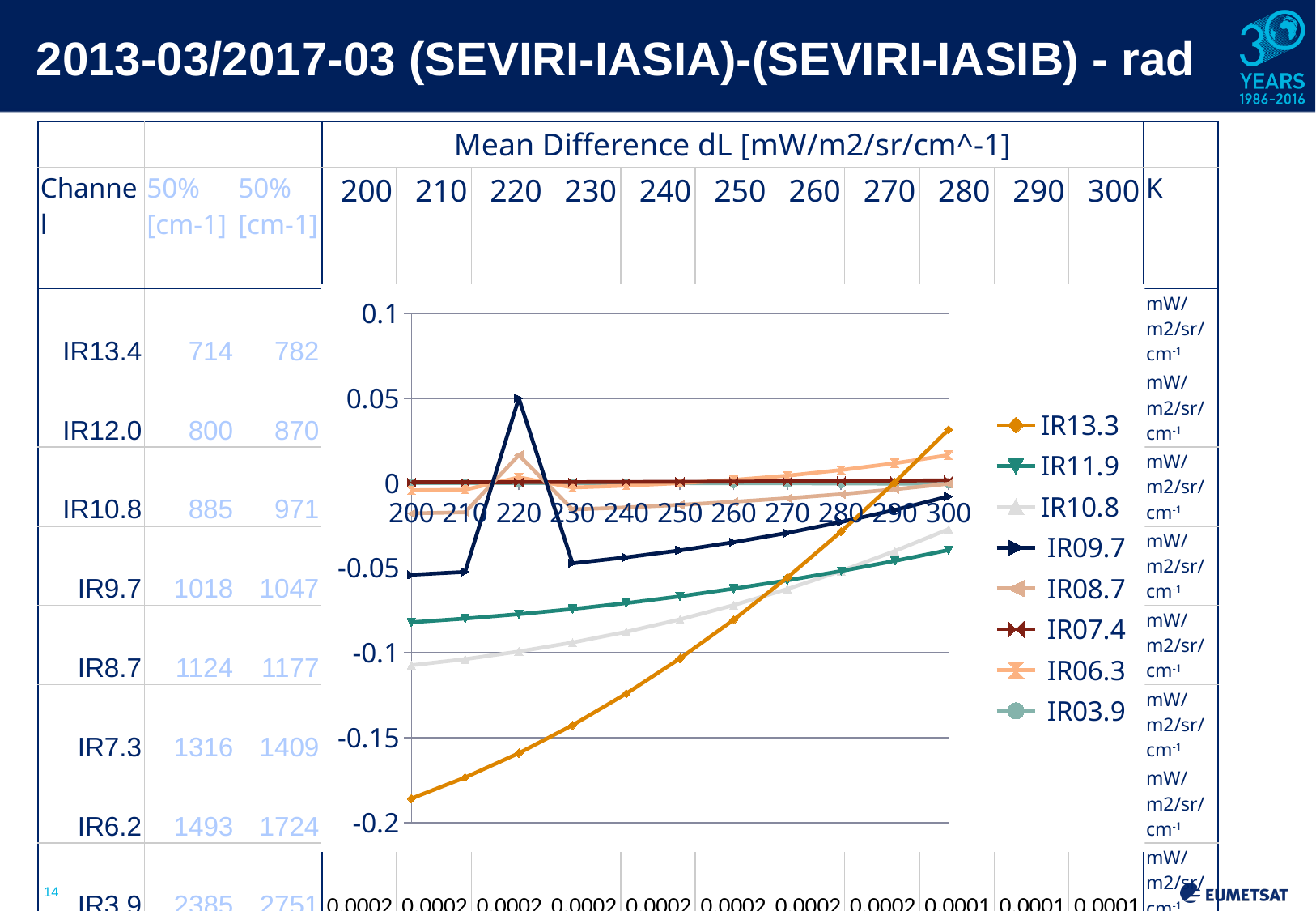
What kind of chart is shown on the slide? line chart Is the value of IR11.9 at x = 200 greater or less than -0.1? greater Does the IR11.9 series rise or fall along the x axis from 200 to 300? rises Which series has the lowest value at x = 200? IR13.3 Which series has the highest value at x = 300? IR13.3 At x = 300, which series has the larger value, IR13.3 or IR11.9? IR13.3 How many x-axis points (from 200 to 300) are plotted for each series? 11 Is the value of IR13.3 at x = 200 greater or less than -0.15? less What is the highest tick value shown on the chart's y axis? 0.1 Is the value of IR09.7 at x = 220 greater or less than 0? greater How many series does the chart legend list? 8 Does the IR13.3 series rise or fall as the x-axis value increases from 200 to 300? rises